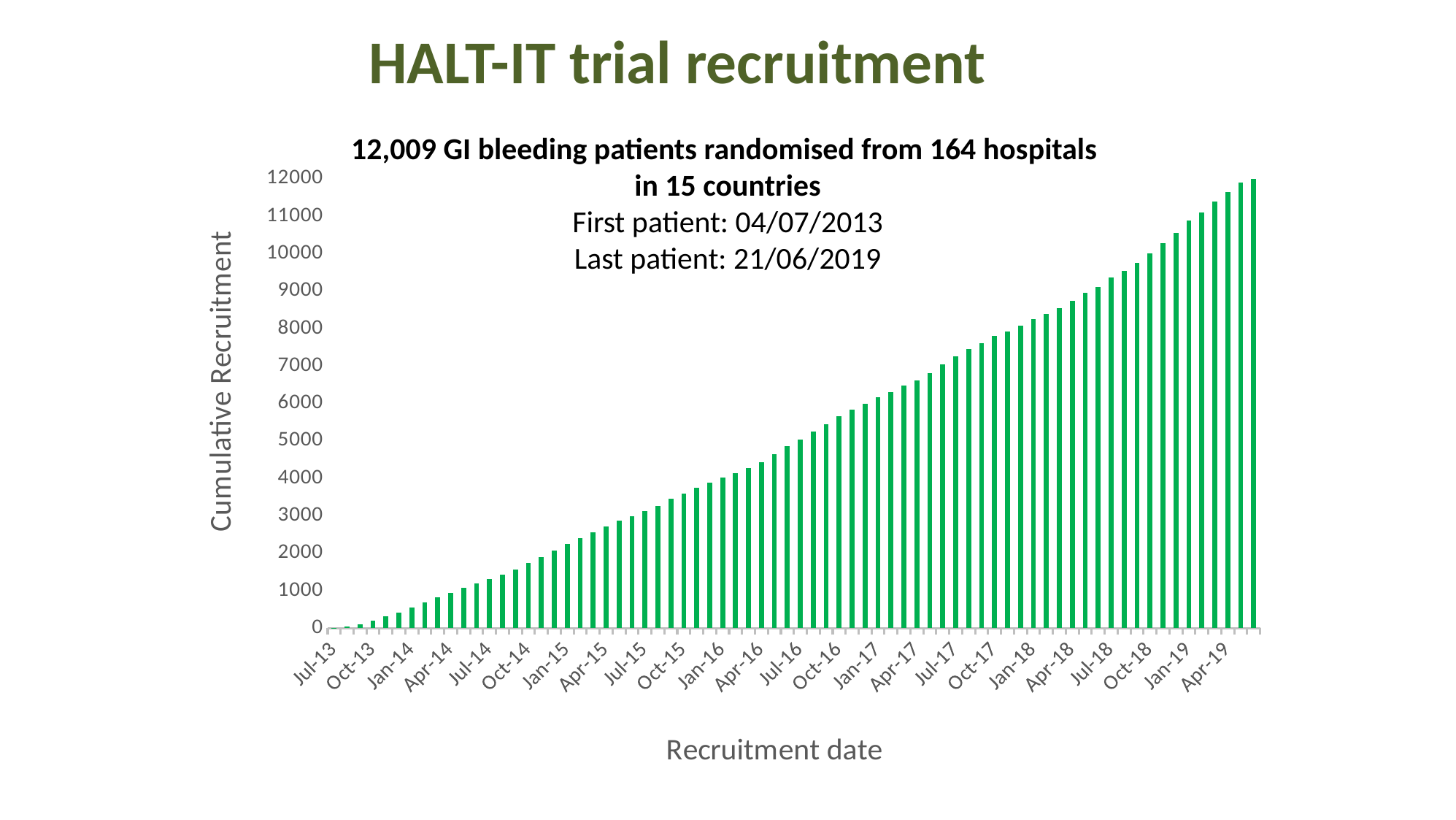
Is the cumulative recruitment for Oct-14 greater or less than 2000? less Is the cumulative recruitment for Jan-14 greater or less than 1000? less Which labelled month has the lowest cumulative recruitment? Jul-13 Do the cumulative recruitment values rise or fall from Jul-13 to Apr-19? rise Is the cumulative recruitment for Jan-19 greater or less than 10000? greater Which has the larger cumulative recruitment, Jan-16 or Jan-17? Jan-17 What is the label of the vertical axis? Cumulative Recruitment What is the label of the horizontal axis? Recruitment date What kind of chart is shown on the slide? bar chart